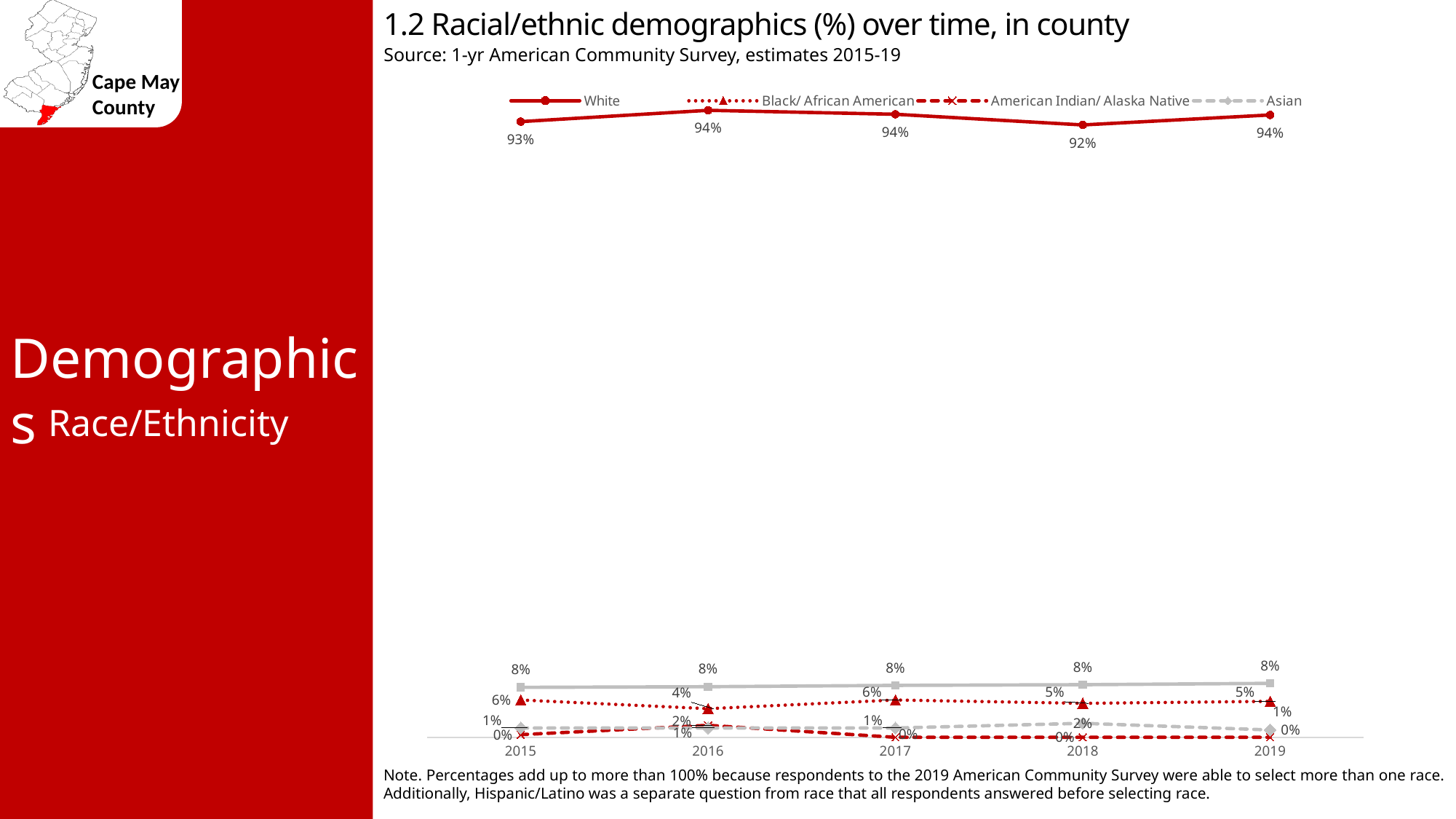
What percentage is shown for Black/ African American in 2016? 4% How many years are shown on the x axis? 5 In which year is the White percentage lowest? 2018 What data source is cited below the chart title? 1-yr American Community Survey, estimates 2015-19 What is the difference between the White percentage in 2016 and in 2018? 2 percentage points Which year has the higher Black/ African American percentage, 2015 or 2016? 2015 What kind of chart is shown on the slide? Line chart Does the White percentage rise or fall from 2017 to 2018? Fall What percentage is shown for White in 2015? 93% What percentage is shown for Black/ African American in 2015? 6% What percentage is shown for White in 2018? 92% What percentage is shown for Black/ African American in 2019? 5%